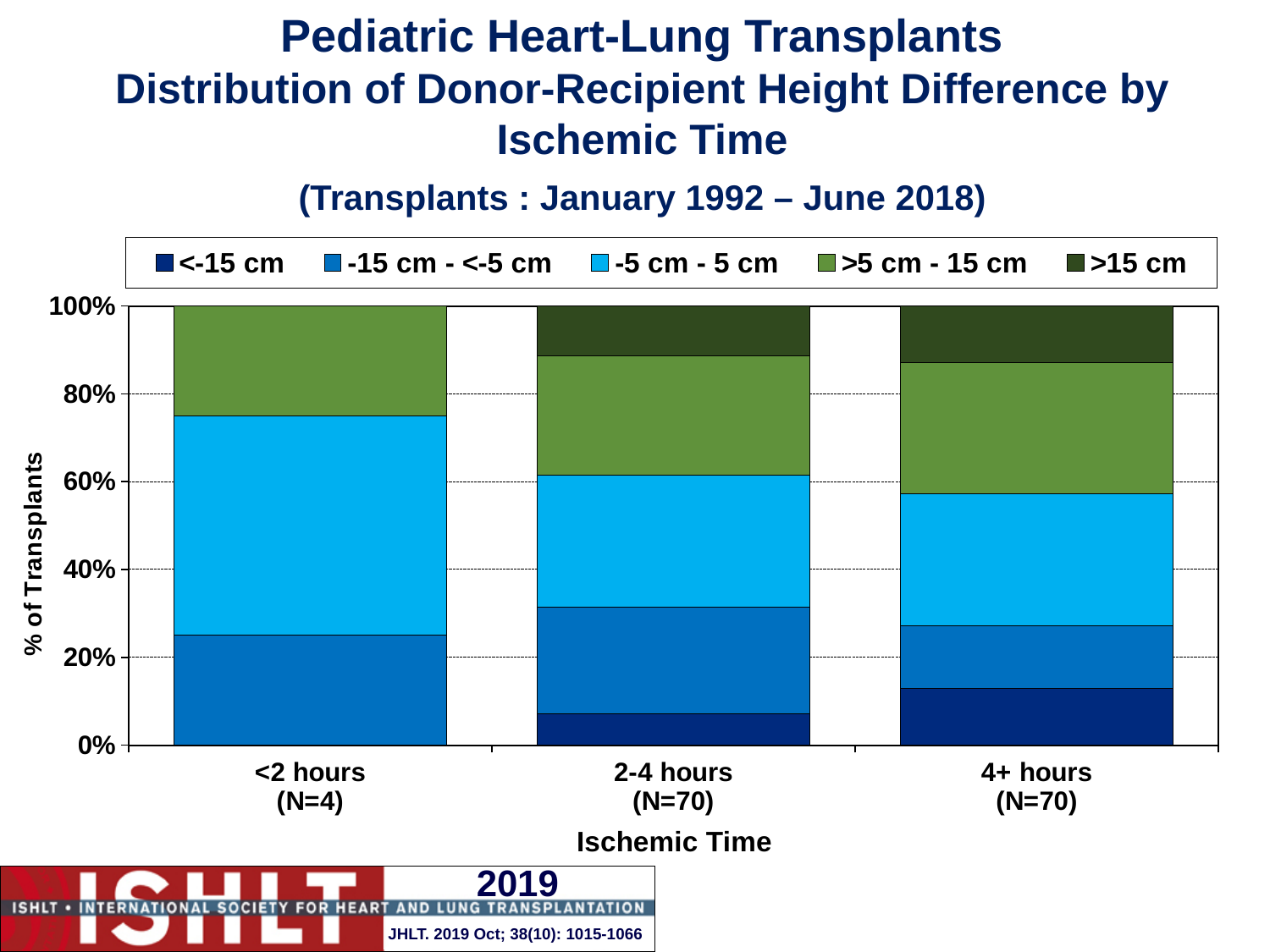
What kind of chart is shown on the slide? Stacked bar chart Is the share of the >5 cm - 15 cm segment for 4+ hours greater or less than 20%? greater Is the share of the >15 cm segment for 2-4 hours greater or less than 20%? less What is the N for the 2-4 hours ischemic time category? N=70 Which ischemic time category has the larger <-15 cm segment, 2-4 hours or 4+ hours? 4+ hours Is the share of the -5 cm - 5 cm segment for <2 hours greater or less than 40%? greater How many ischemic time categories are shown on the x axis? 3 How many series does the legend list? 5 Which ischemic time category has the largest -5 cm - 5 cm segment? <2 hours What is the label of the y axis? % of Transplants Which ischemic time category has the smallest <-15 cm segment? <2 hours